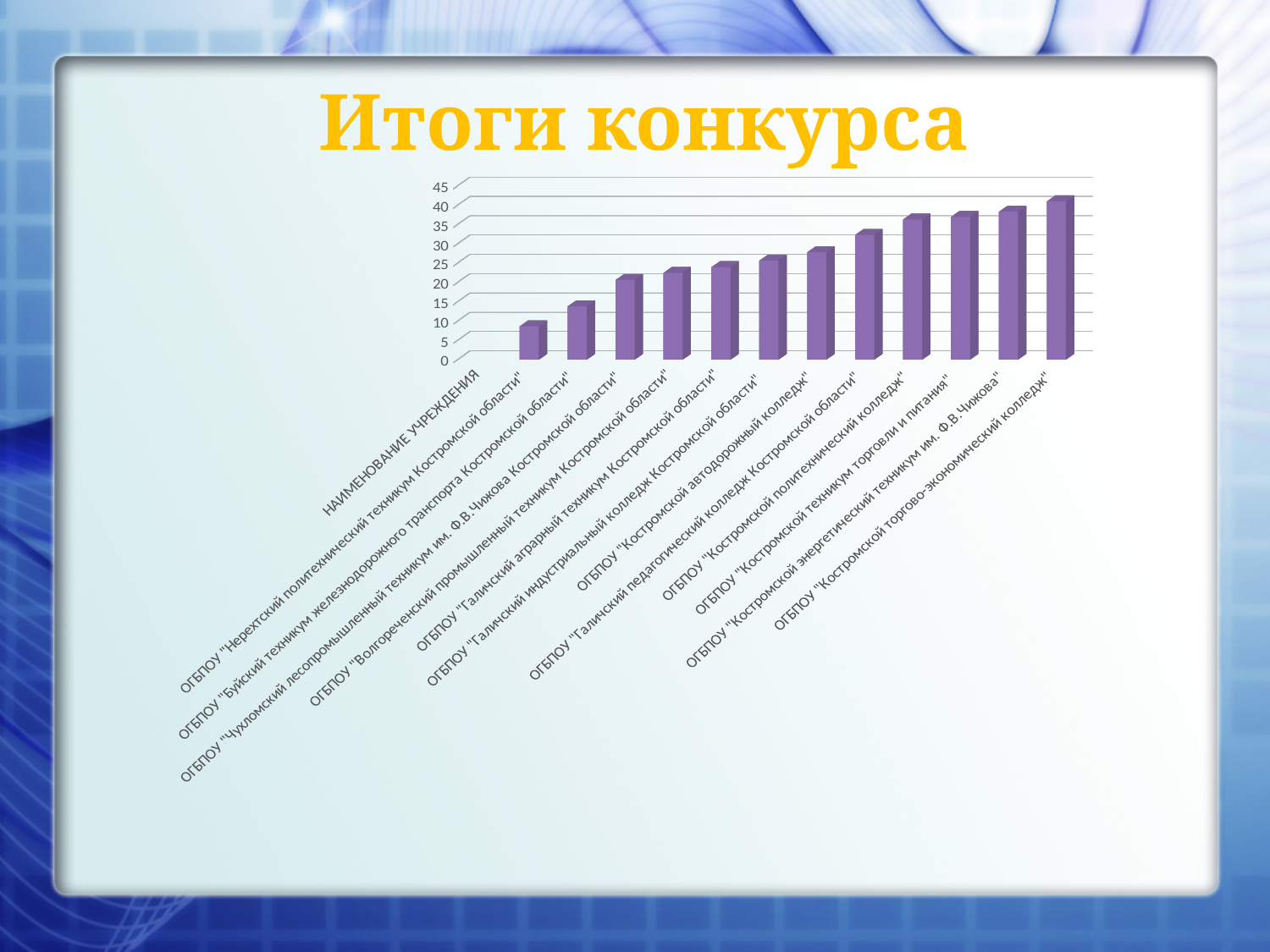
Which institution has the highest bar in the chart? ОГБПОУ "Костромской торгово-экономический колледж" Do the bar values rise or fall from left to right along the x axis? rise What colour are the bars in the chart? purple What is the title of the slide with the chart? Итоги конкурса Is the value for ОГБПОУ "Галичский педагогический колледж Костромской области" greater or less than 30? greater What kind of chart is shown on the slide? bar chart Which institution has the lowest bar in the chart? ОГБПОУ "Нерехтский политехнический техникум Костромской области" Is the value for ОГБПОУ "Костромской автодорожный колледж" greater or less than 30? less Is the value for ОГБПОУ "Нерехтский политехнический техникум Костромской области" greater or less than 10? less How many bars are plotted in the chart? 12 Which has the larger value: ОГБПОУ "Буйский техникум железнодорожного транспорта Костромской области" or ОГБПОУ "Костромской политехнический колледж"? ОГБПОУ "Костромской политехнический колледж"